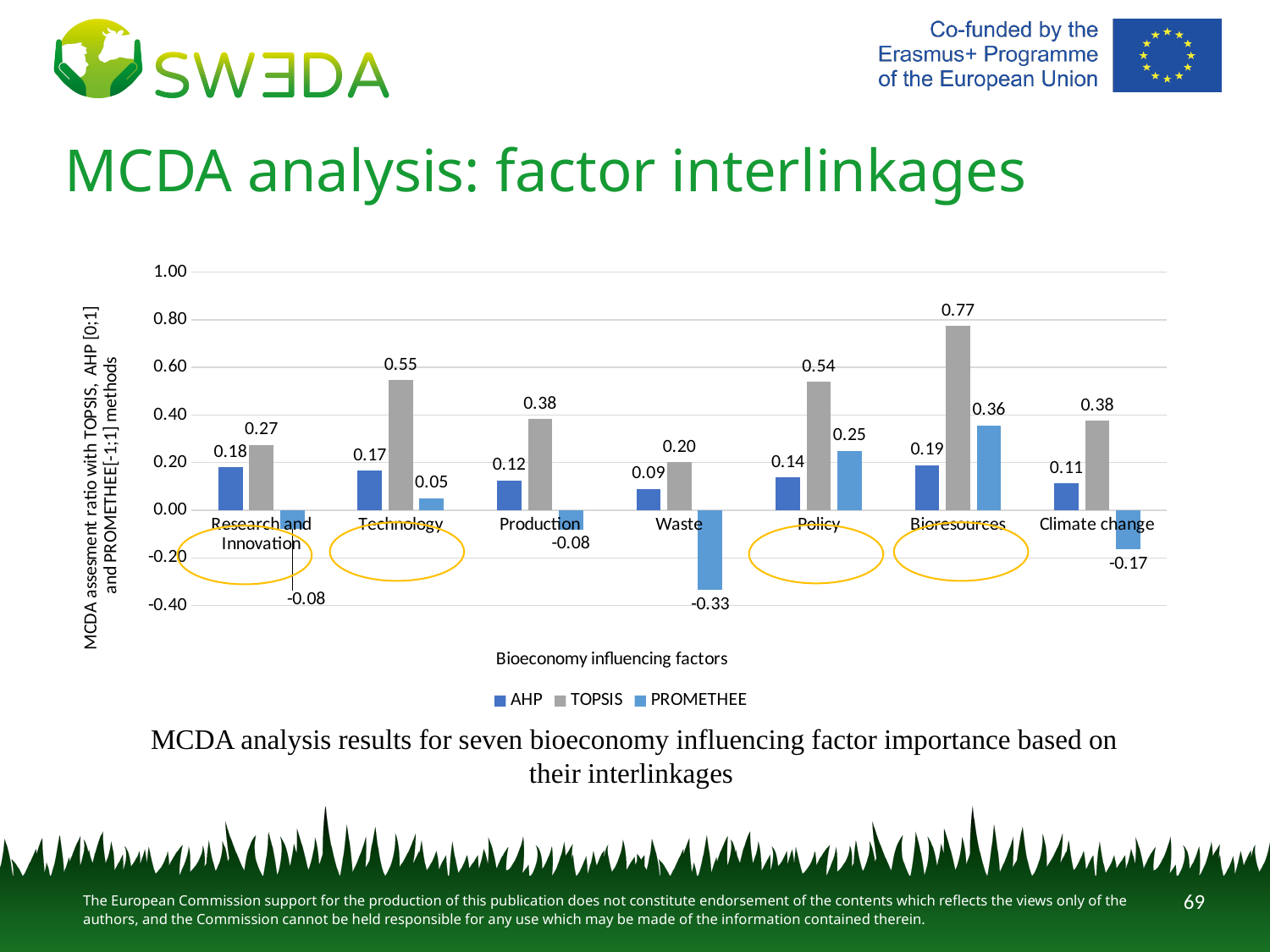
What type of chart is shown on the slide? bar chart What is the AHP value for Policy? 0.14 Which factor has the lowest AHP value? Waste Which factor has the lowest PROMETHEE value? Waste How many bioeconomy influencing factors are shown on the x axis? 7 What is the difference between the TOPSIS values for Bioresources and Technology? 0.22 Which is larger, the PROMETHEE value for Policy or the PROMETHEE value for Bioresources? Bioresources What is the PROMETHEE value for Waste? -0.33 How many series does the legend list? 3 What is the label of the y axis? MCDA assesment ratio with TOPSIS, AHP [0;1] and PROMETHEE[-1;1] methods What is the TOPSIS value for Bioresources? 0.77 Which factor has the highest TOPSIS value? Bioresources